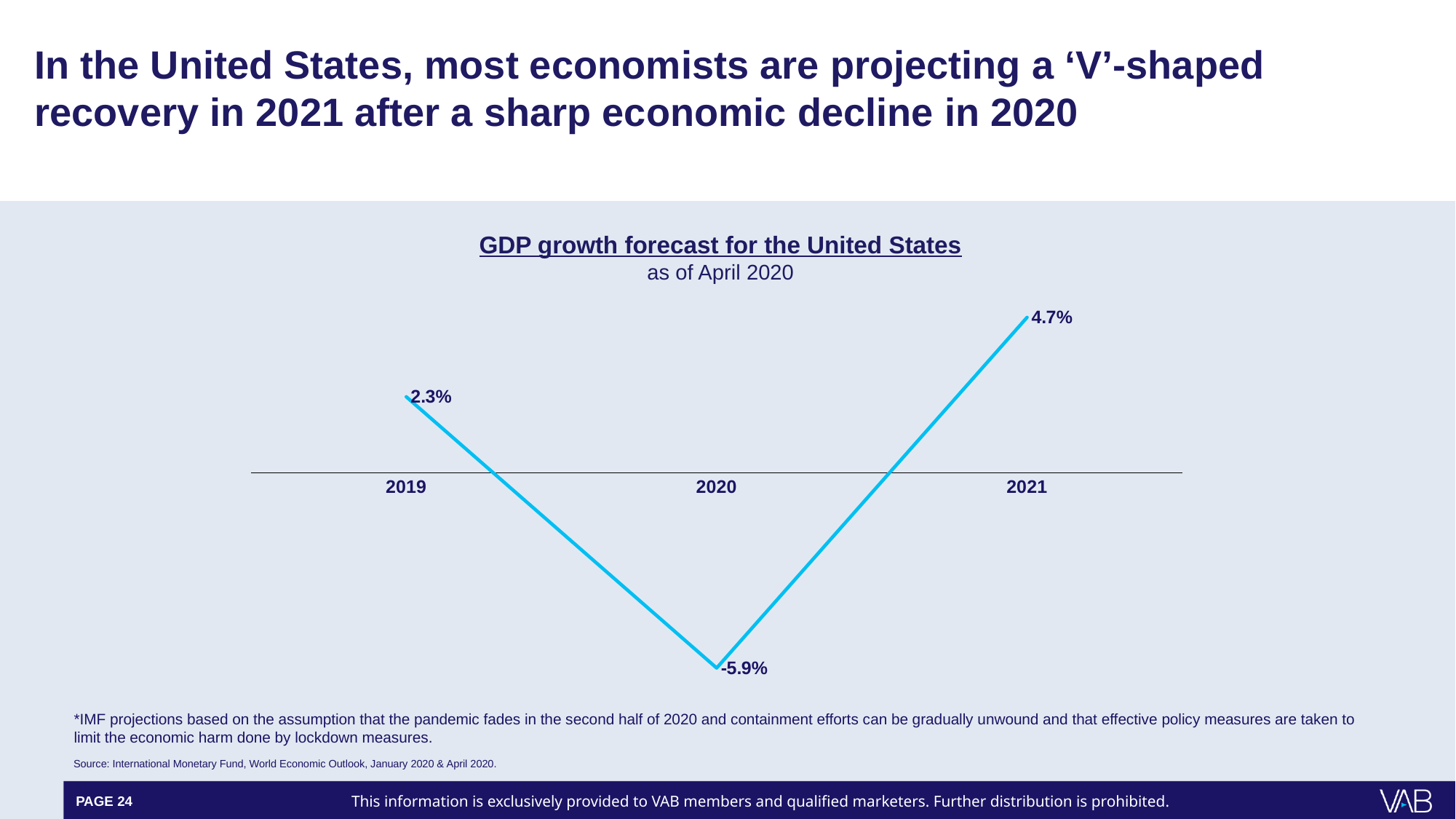
What is the GDP growth forecast for the United States for 2021? 4.7% What is the difference between the 2021 and 2020 GDP growth forecasts? 10.6 percentage points Which year has the highest GDP growth forecast on the chart? 2021 What is the title of the chart? GDP growth forecast for the United States What is the GDP growth forecast for the United States for 2019? 2.3% What is the difference between the 2021 and 2019 GDP growth forecasts? 2.4 percentage points Does the GDP growth forecast rise or fall from 2019 to 2020? Fall Which year has the lowest GDP growth forecast on the chart? 2020 How many years are plotted on the chart? 3 Which is larger, the GDP growth forecast for 2019 or for 2021? 2021 What kind of chart is shown on the slide? Line chart What is the GDP growth forecast for the United States for 2020? -5.9%